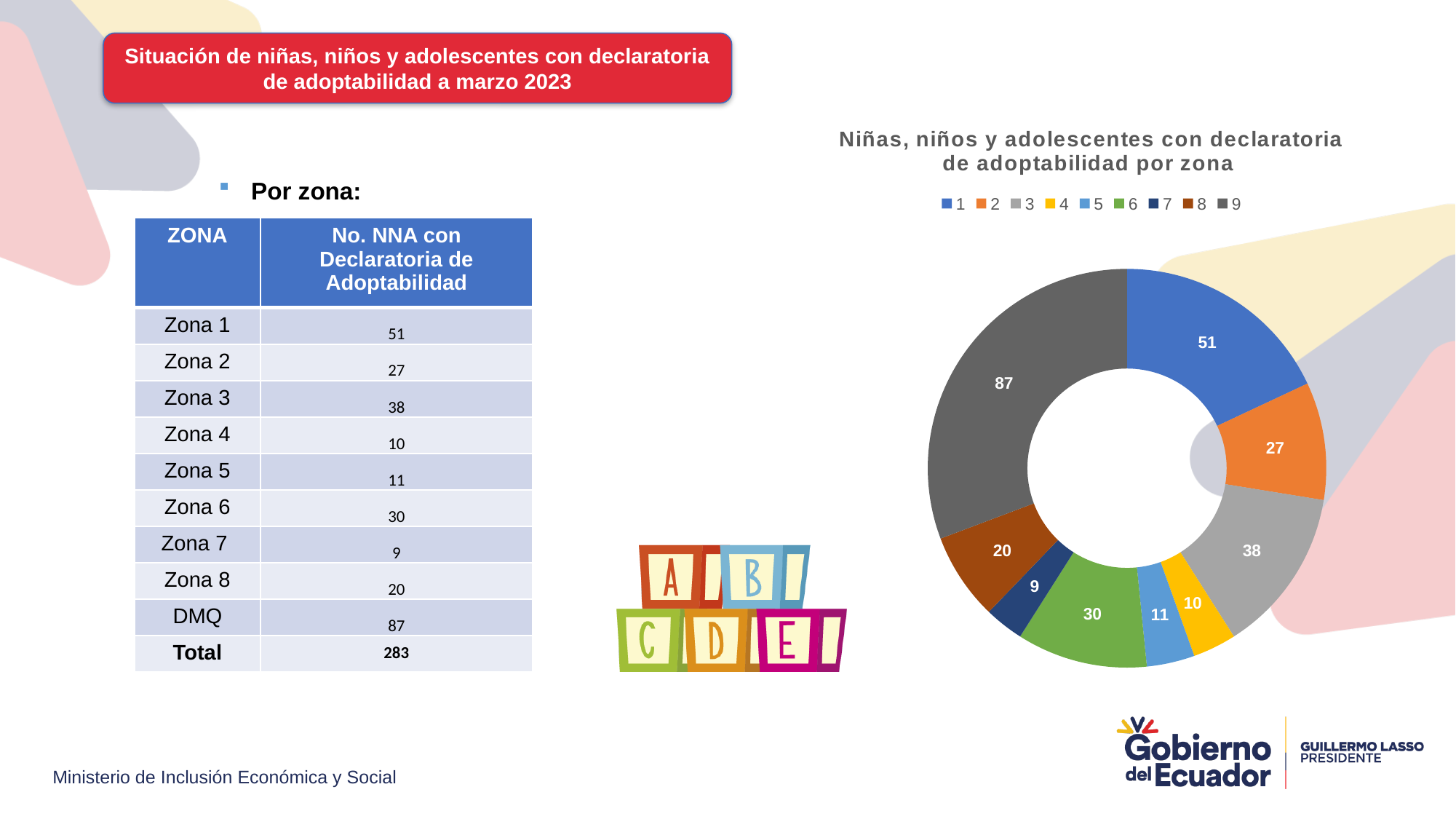
In the doughnut chart, what is the difference between the slice for legend entry 9 and the slice for legend entry 1? 36 In the doughnut chart, what is the value of the slice for legend entry 8? 20 What type of chart is shown on the right of the slide? doughnut chart What is the title of the doughnut chart? Niñas, niños y adolescentes con declaratoria de adoptabilidad por zona Which legend entry has the largest slice in the doughnut chart? 9 How many slices does the doughnut chart have? 9 What is the sum of all slice values in the doughnut chart? 283 In the doughnut chart, what is the value of the slice for legend entry 1? 51 In the doughnut chart, what is the value of the slice for legend entry 6? 30 How many entries does the legend of the doughnut chart list? 9 Which legend entry has the smallest slice in the doughnut chart? 7 In the doughnut chart, which slice is larger: legend entry 3 or legend entry 2? 3